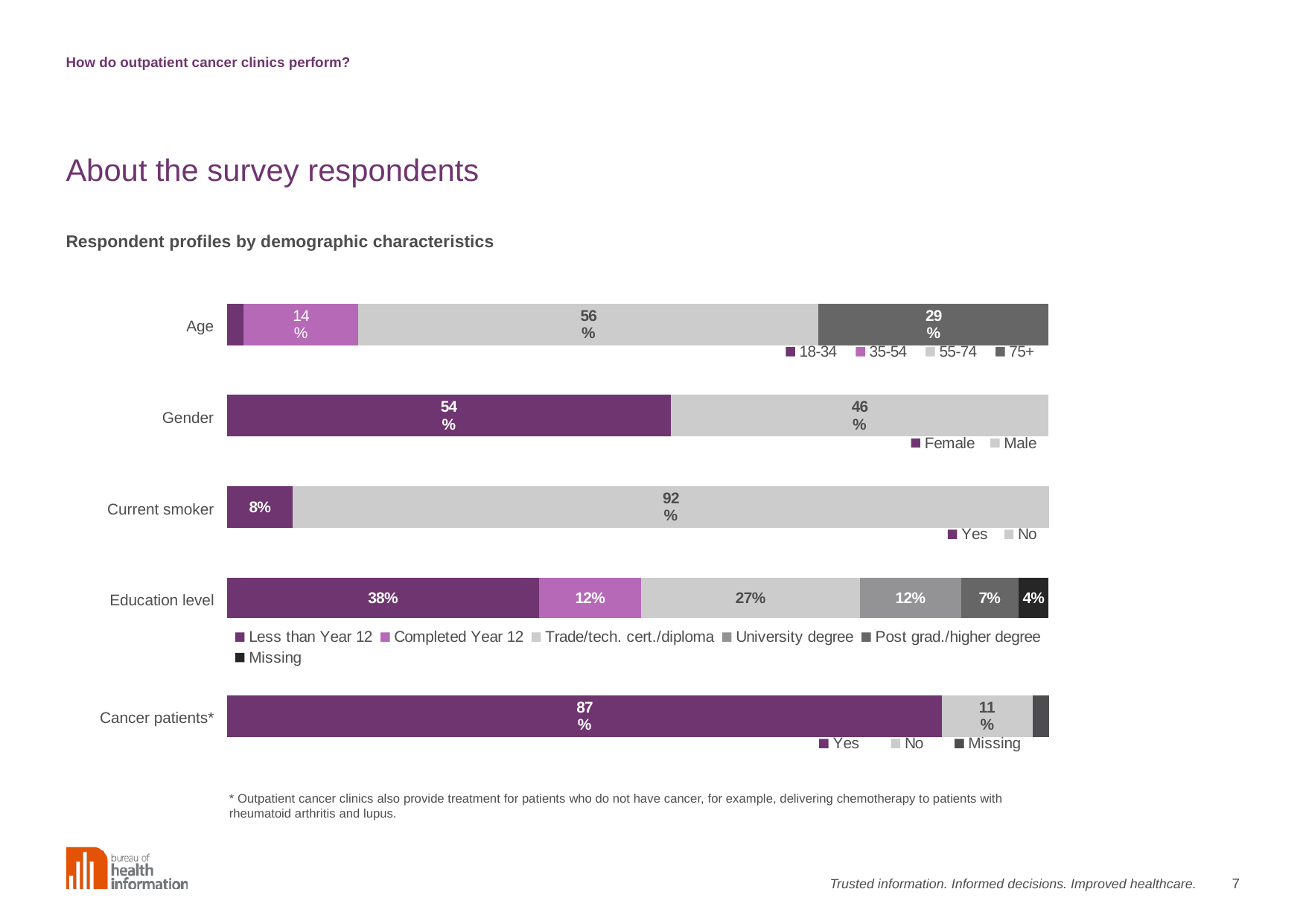
In the Gender chart, what is the difference between the Female and Male percentages? 8% In the Cancer patients chart, what percentage of respondents answered Yes? 87% In the Education level chart, which education category has the largest share? Less than Year 12 In the Gender chart, what percentage of respondents are female? 54% What type of chart is used for the Current smoker data? Stacked bar chart In the Current smoker chart, what percentage of respondents answered No? 92% In the Education level chart, what percentage of respondents have less than Year 12? 38% How many series does the legend of the Age chart list? 4 In the Age chart, which is larger, the share aged 35-54 or the share aged 75+? 75+ In the Age chart, what percentage of respondents are aged 55-74? 56% How many series does the legend of the Education level chart list? 6 In the Education level chart, which category has the smallest share? Missing